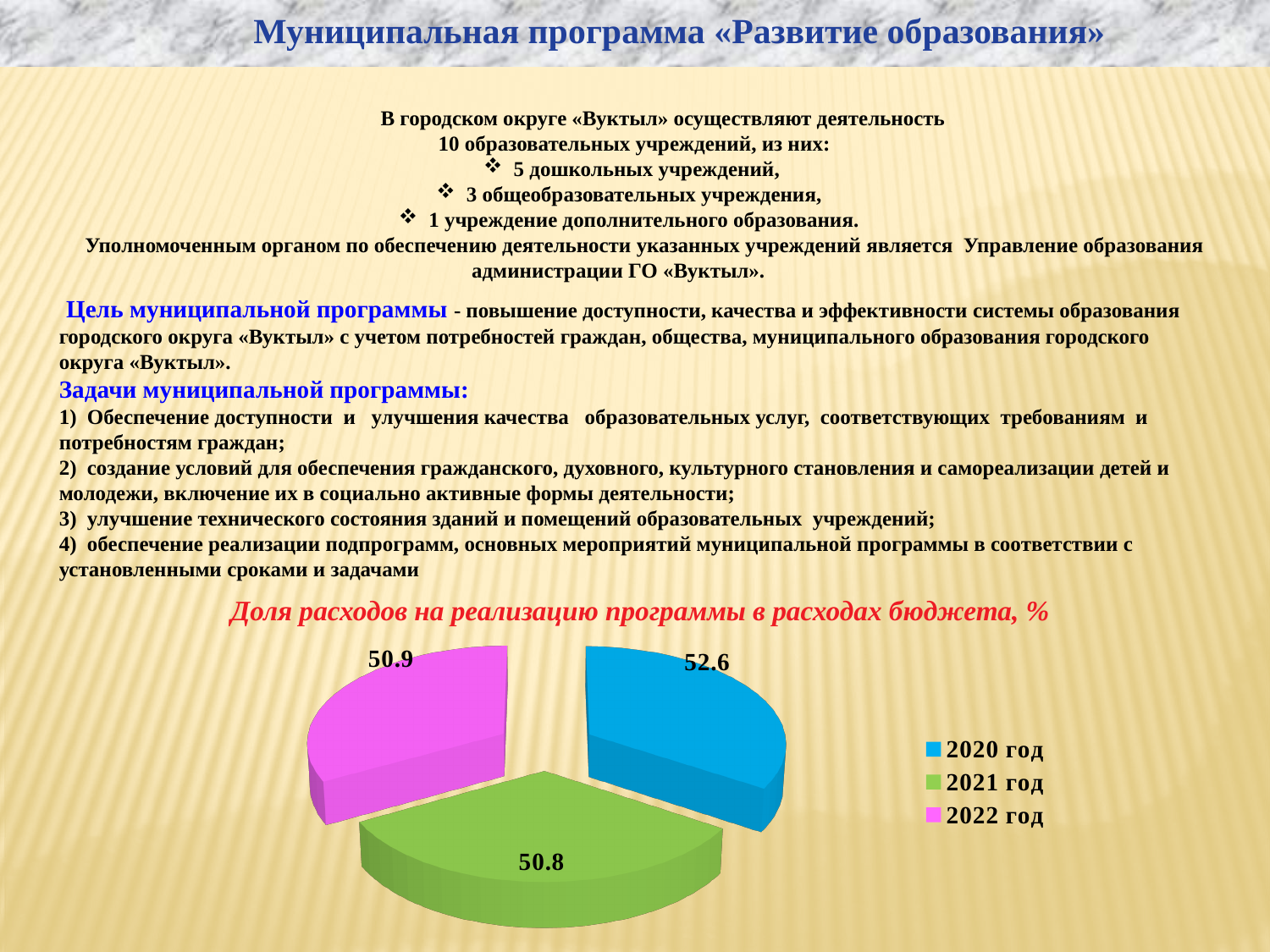
Which is larger, the value for 2020 год or the value for 2022 год? 2020 год What kind of chart is shown on the slide? Pie chart What colour is the slice for 2021 год? Green What is the value shown for 2020 год in the pie chart? 52.6 How many entries does the chart legend list? 3 What is the difference between the values for 2020 год and 2021 год? 1.8 What is the difference between the values for 2020 год and 2022 год? 1.7 What is the value shown for 2022 год in the pie chart? 50.9 Which year has the lowest value in the pie chart? 2021 год What is the value shown for 2021 год in the pie chart? 50.8 Which year has the highest value in the pie chart? 2020 год How many slices does the pie chart have? 3